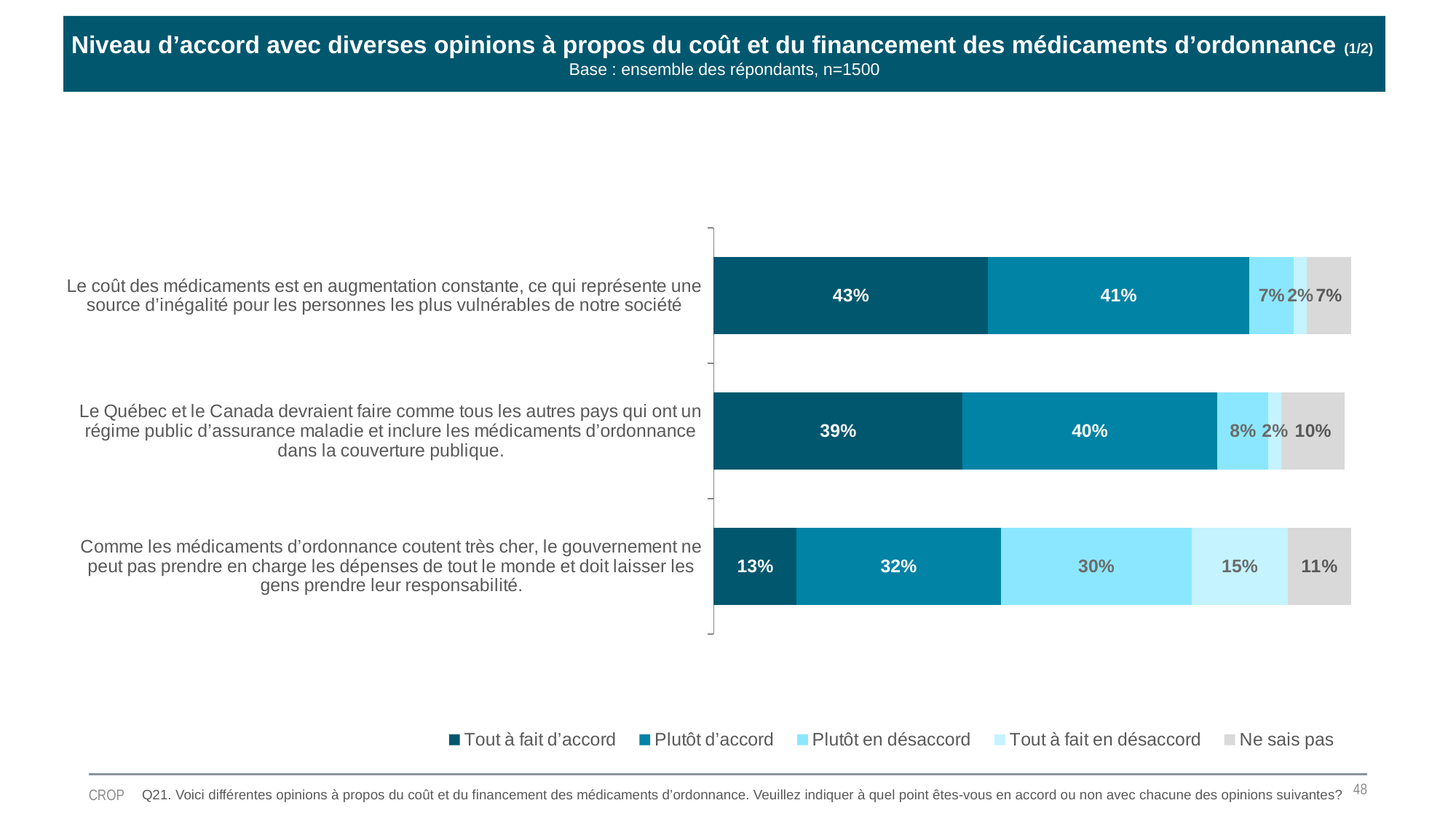
How many statements are shown in the chart? 3 What percentage of respondents are "Plutôt d'accord" with the statement that Québec and Canada should include prescription drugs in public coverage like other countries with a public health insurance plan? 40% What type of chart is shown on the slide? Stacked horizontal bar chart What percentage of respondents answered "Ne sais pas" for the statement that the government cannot cover everyone's expenses and must let people take responsibility? 11% What is the base (number of respondents) indicated under the chart title? n=1500 How many response categories does the legend list? 5 What percentage of respondents are "Tout à fait en désaccord" with the statement that the government cannot cover everyone's expenses and must let people take responsibility? 15% Which statement has the highest share of "Tout à fait d'accord" responses? Le coût des médicaments est en augmentation constante, ce qui représente une source d'inégalité pour les personnes les plus vulnérables de notre société Which statement has the lowest share of "Tout à fait d'accord" responses? Comme les médicaments d'ordonnance coutent très cher, le gouvernement ne peut pas prendre en charge les dépenses de tout le monde et doit laisser les gens prendre leur responsabilité. Which is larger: the "Plutôt d'accord" share for the statement about the cost of medications increasing, or the "Plutôt d'accord" share for the statement about the government letting people take responsibility? The statement about the cost of medications increasing (41%) What percentage of respondents are "Tout à fait d'accord" with the statement that the cost of medications is constantly increasing, representing a source of inequality for the most vulnerable? 43% What is the difference in "Plutôt en désaccord" responses between the statement about the government letting people take responsibility (30%) and the statement about the cost of medications increasing (7%)? 23 percentage points